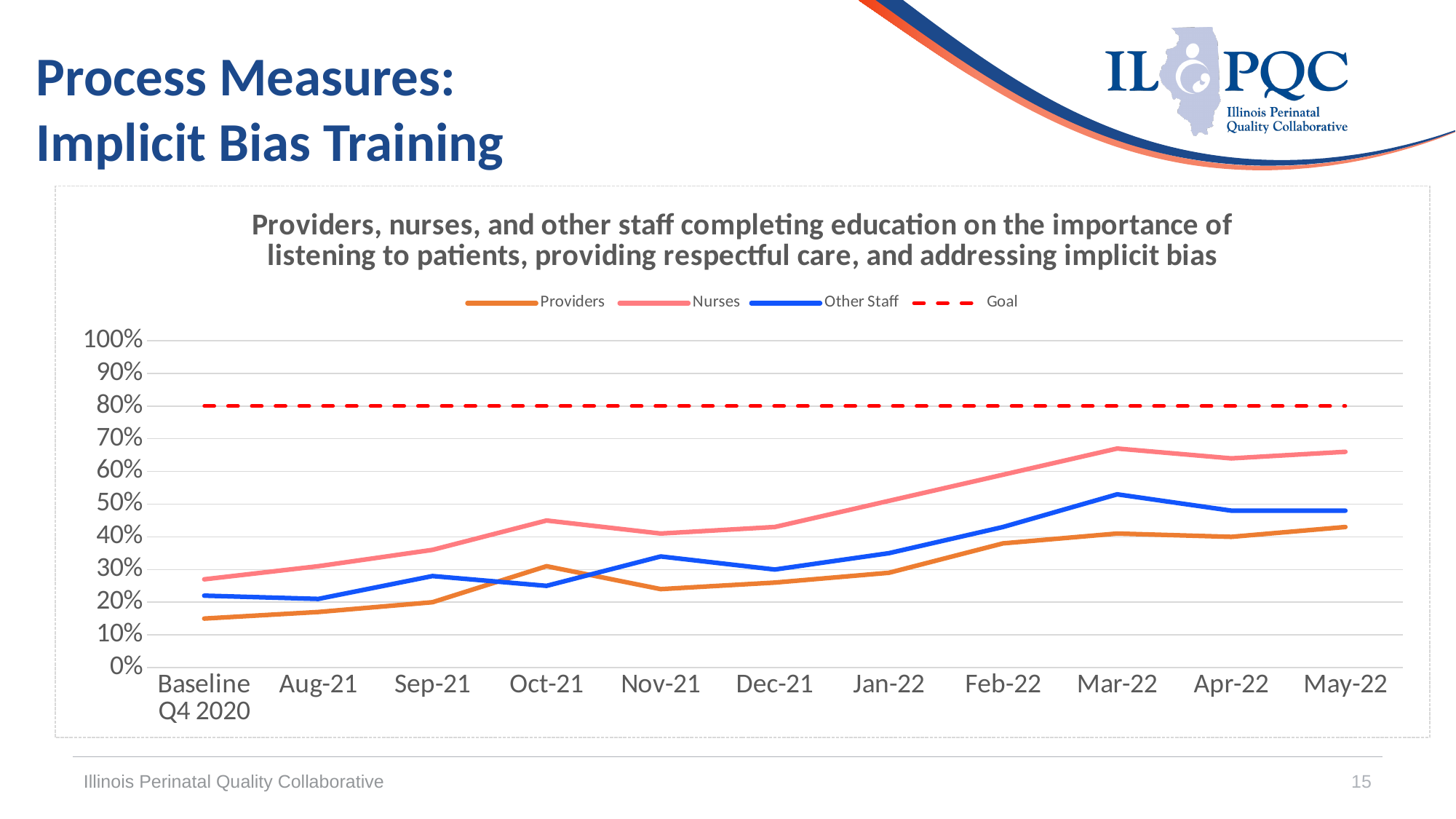
How many time points are shown on the x axis? 11 What kind of chart is shown on the slide? Line chart Which series has the highest value in Mar-22? Nurses Does the Nurses line generally rise or fall from Baseline Q4 2020 to May-22? Rise Is the value for Nurses in Mar-22 greater or less than 60%? greater What value is the Goal line set at? 80% Is the value for Providers at Baseline Q4 2020 greater or less than 20%? less Is the value for Providers in Nov-21 greater or less than 30%? less In May-22, which is higher: Nurses or Providers? Nurses In Nov-21, which is higher: Other Staff or Providers? Other Staff How many series does the legend list? 4